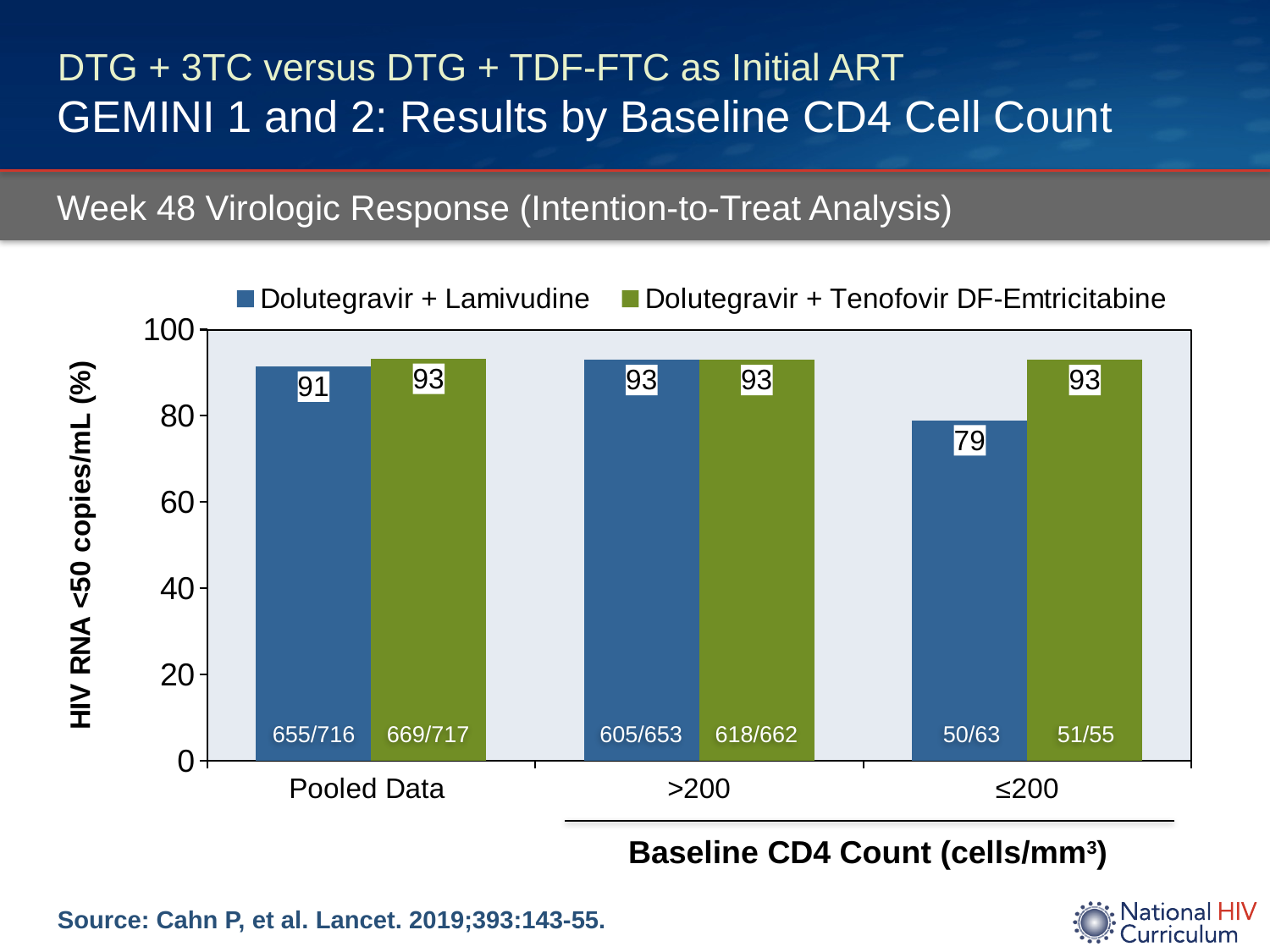
What is the value for Dolutegravir + Lamivudine in the ≤200 baseline CD4 group? 79 What kind of chart is shown on the slide? Bar chart Which baseline CD4 category has the lowest value for Dolutegravir + Lamivudine? ≤200 What is the Week 48 virologic response for Dolutegravir + Tenofovir DF-Emtricitabine in the ≤200 baseline CD4 group? 93 What fraction of participants is shown inside the Dolutegravir + Lamivudine bar for the ≤200 group? 50/63 How many series does the legend list? 2 What is the difference between the Dolutegravir + Tenofovir DF-Emtricitabine and Dolutegravir + Lamivudine values in the ≤200 group? 14 What is the Week 48 virologic response for Dolutegravir + Lamivudine in the Pooled Data group? 91 What is the label of the y axis? HIV RNA <50 copies/mL (%) In the Pooled Data group, which regimen has the higher virologic response? Dolutegravir + Tenofovir DF-Emtricitabine How many categories are shown on the x axis? 3 Is the value for Dolutegravir + Lamivudine in the ≤200 group greater or less than 80? less